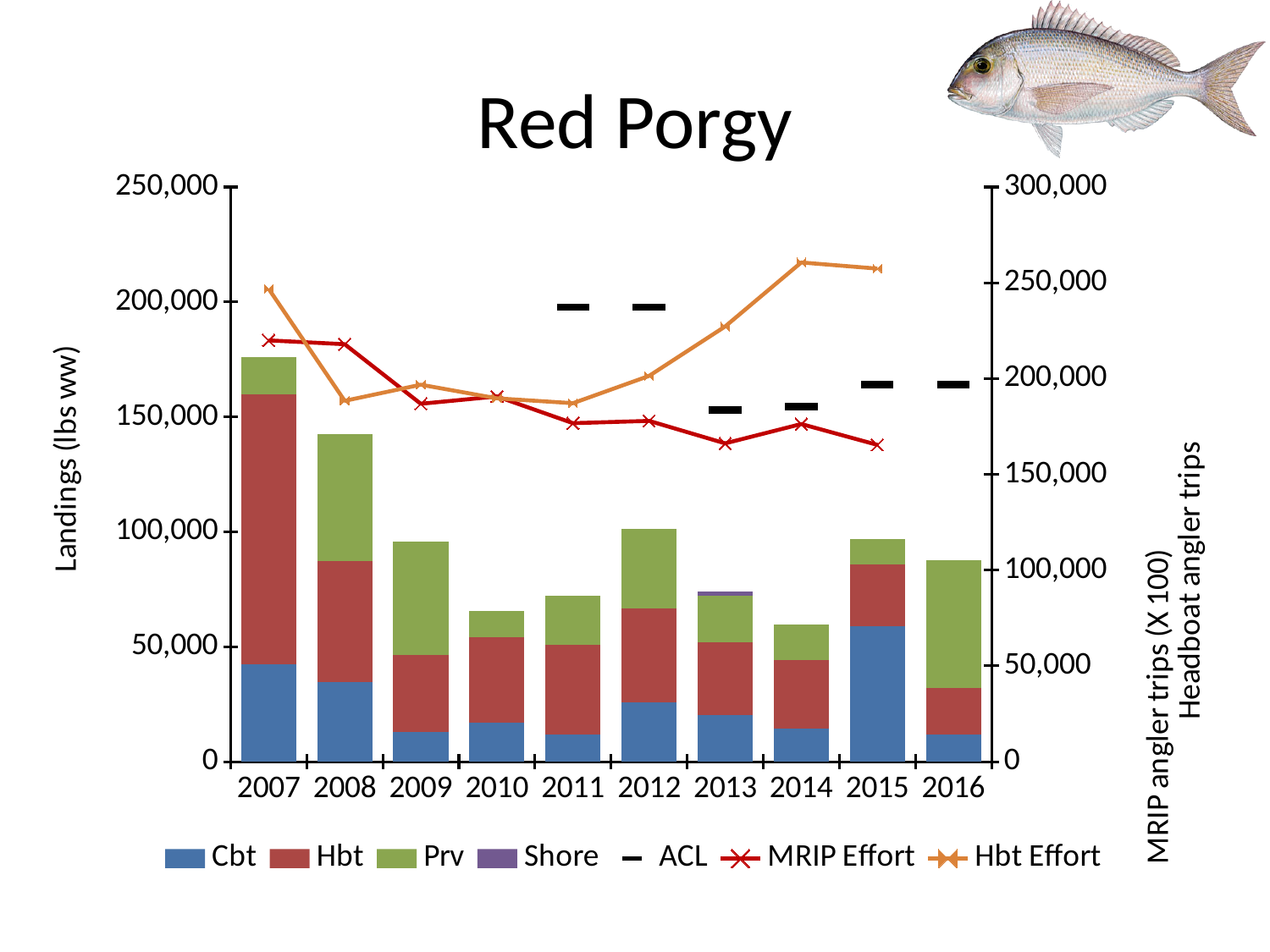
What kind of chart is used to show the landings by sector? Stacked bar chart (with line series overlaid) What is the title of the chart? Red Porgy Which year has the largest Cbt (blue) segment? 2015 Which is larger, the total landings bar for 2011 or for 2012? 2012 Does the MRIP Effort line generally rise or fall from 2007 to 2015? fall Is the total landings value for 2014 greater or less than 100,000? less How many years are shown on the x axis? 10 In which year does the Hbt Effort line reach its highest point? 2014 Which year has the largest Hbt (red) segment? 2007 How many series does the legend list? 7 Is the MRIP Effort value for 2015 greater or less than 200,000? less